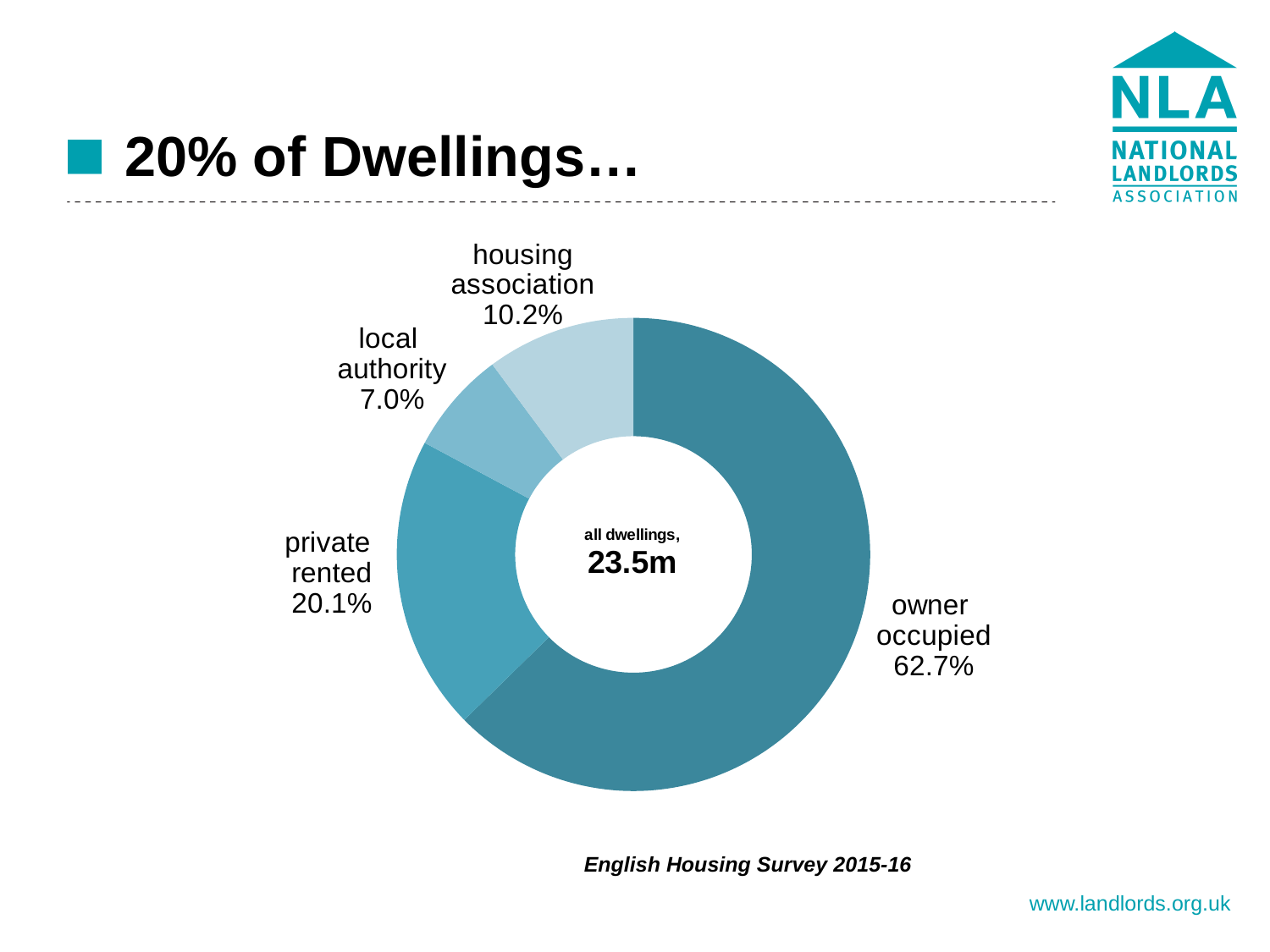
Which is larger, the private rented share or the housing association share? private rented What total number of dwellings is shown in the centre of the chart? 23.5m How many categories are shown in the chart? 4 What share of dwellings is owner occupied? 62.7% What kind of chart is shown on the slide? doughnut (pie) chart What is the difference in percentage points between the owner occupied and private rented shares? 42.6 Which category has the smallest share of dwellings? local authority Which category has the largest share of dwellings? owner occupied What share of dwellings is housing association? 10.2% What share of dwellings is private rented? 20.1% What is the difference in percentage points between the housing association and local authority shares? 3.2 What share of dwellings is local authority? 7.0%